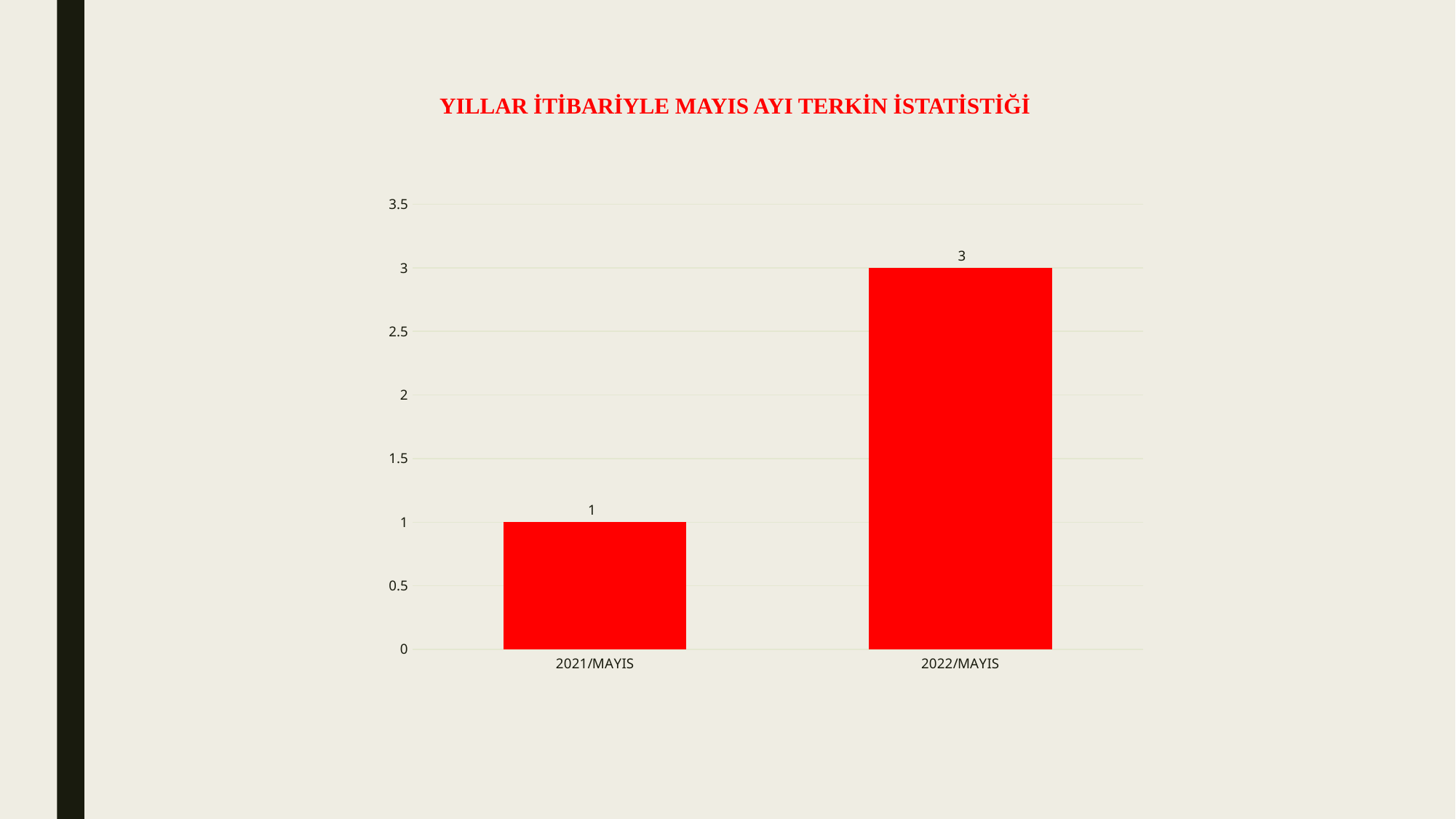
Is the value for 2021/MAYIS greater or less than 2? less What is the value for 2021/MAYIS? 1 Do the values rise or fall from 2021/MAYIS to 2022/MAYIS? rise What is the title of the chart? YILLAR İTİBARİYLE MAYIS AYI TERKİN İSTATİSTİĞİ How many categories are shown on the x axis? 2 Which category has the lowest value? 2021/MAYIS What is the difference between the values for 2022/MAYIS and 2021/MAYIS? 2 Is the value for 2022/MAYIS greater or less than 2? greater What is the value for 2022/MAYIS? 3 Which is larger, the value for 2021/MAYIS or the value for 2022/MAYIS? 2022/MAYIS Which category has the highest value? 2022/MAYIS What kind of chart is shown on the slide? bar chart